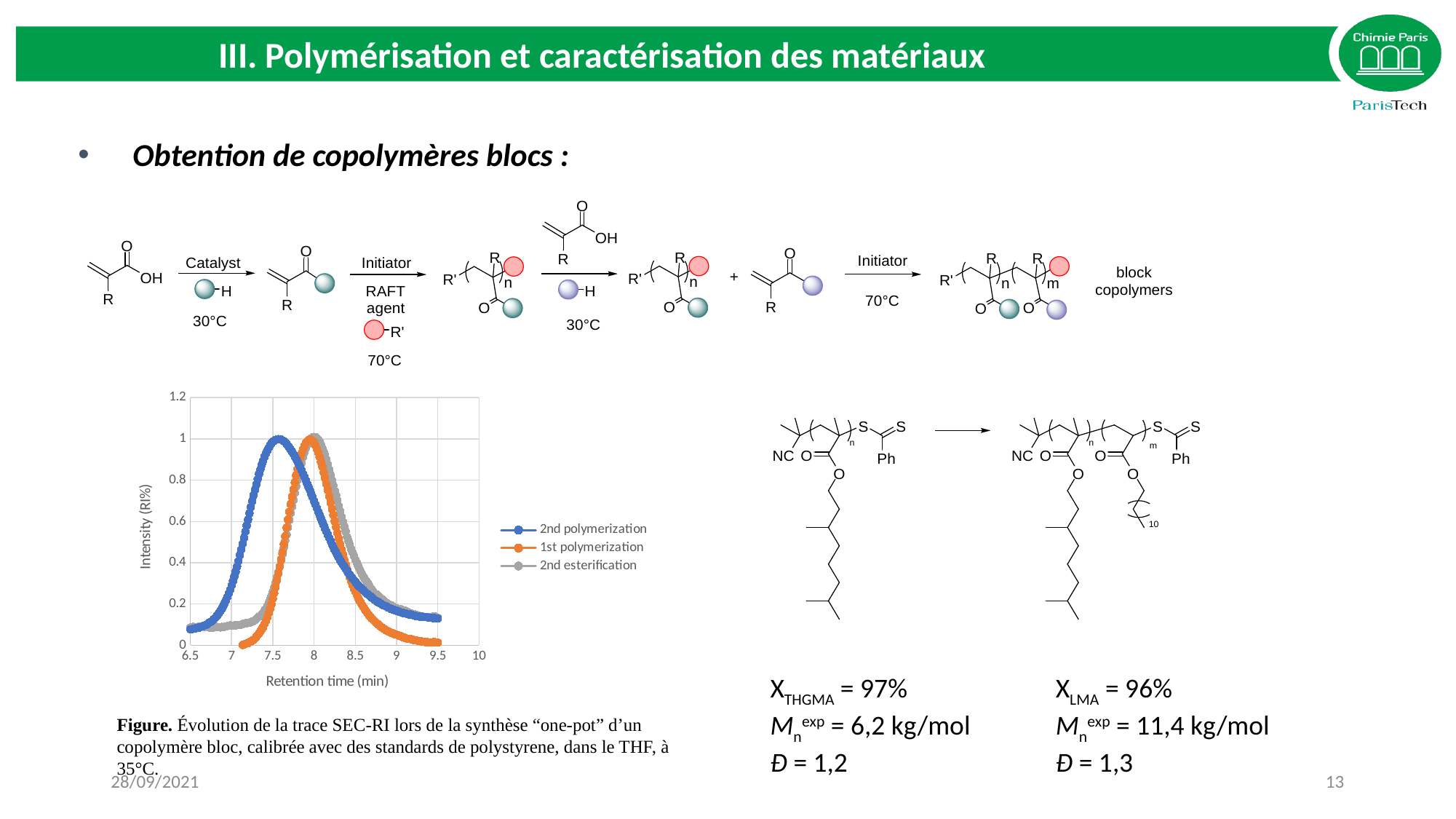
Which series reaches its peak at the lowest retention time? 2nd polymerization What kind of chart is shown on the slide? line chart Is the value of the 2nd polymerization series at 8.5 min greater or less than 0.6? less What is the label of the y axis of the chart? Intensity (RI%) At 7.5 min, which series has the higher intensity: 2nd polymerization or 1st polymerization? 2nd polymerization Does the 1st polymerization series rise or fall between 7 min and 8 min? rise What is the label of the x axis of the chart? Retention time (min) Does the 2nd polymerization series rise or fall between 7.5 min and 9.5 min? fall Is the peak value of the 2nd polymerization series greater or less than 0.8? greater Is the value of the 2nd esterification series at 9.5 min greater or less than 0.2? less How many series does the chart legend list? 3